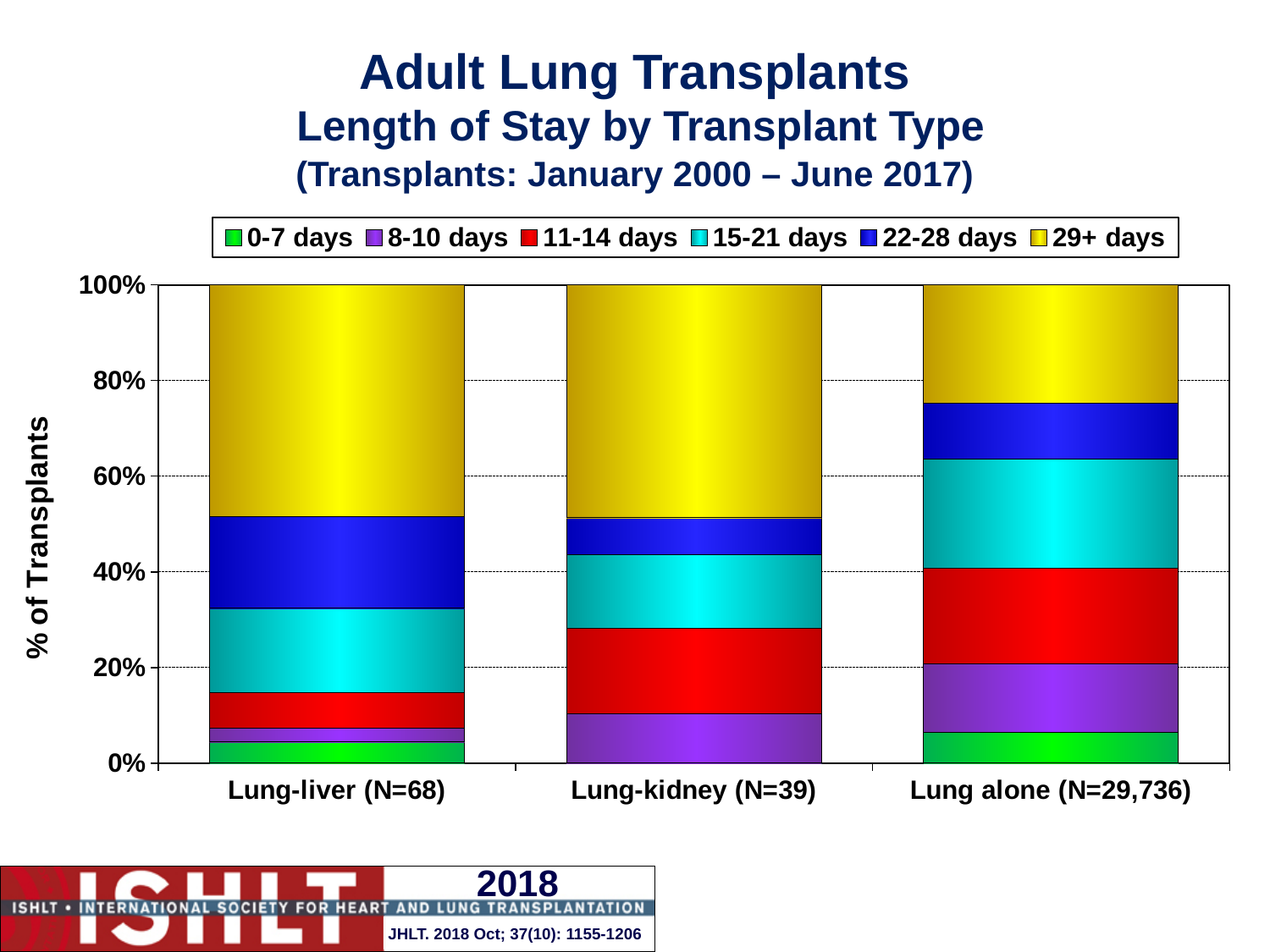
Is the 29+ days share for Lung alone greater or less than 40%? less What kind of chart is shown on the slide? Stacked bar chart How many transplant type categories are shown on the x axis? 3 What is the N shown for the Lung alone category? 29,736 What is the label of the y axis? % of Transplants Which has a larger 29+ days share, Lung-kidney or Lung alone? Lung-kidney Which has a larger 8-10 days share, Lung alone or Lung-liver? Lung alone Which transplant type has the largest 22-28 days share? Lung-liver Is the 29+ days share for Lung-liver greater or less than 40%? greater How many length-of-stay series does the legend list? 6 Is the 8-10 days share for Lung-liver greater or less than 20%? less Which transplant type has the smallest 29+ days share? Lung alone